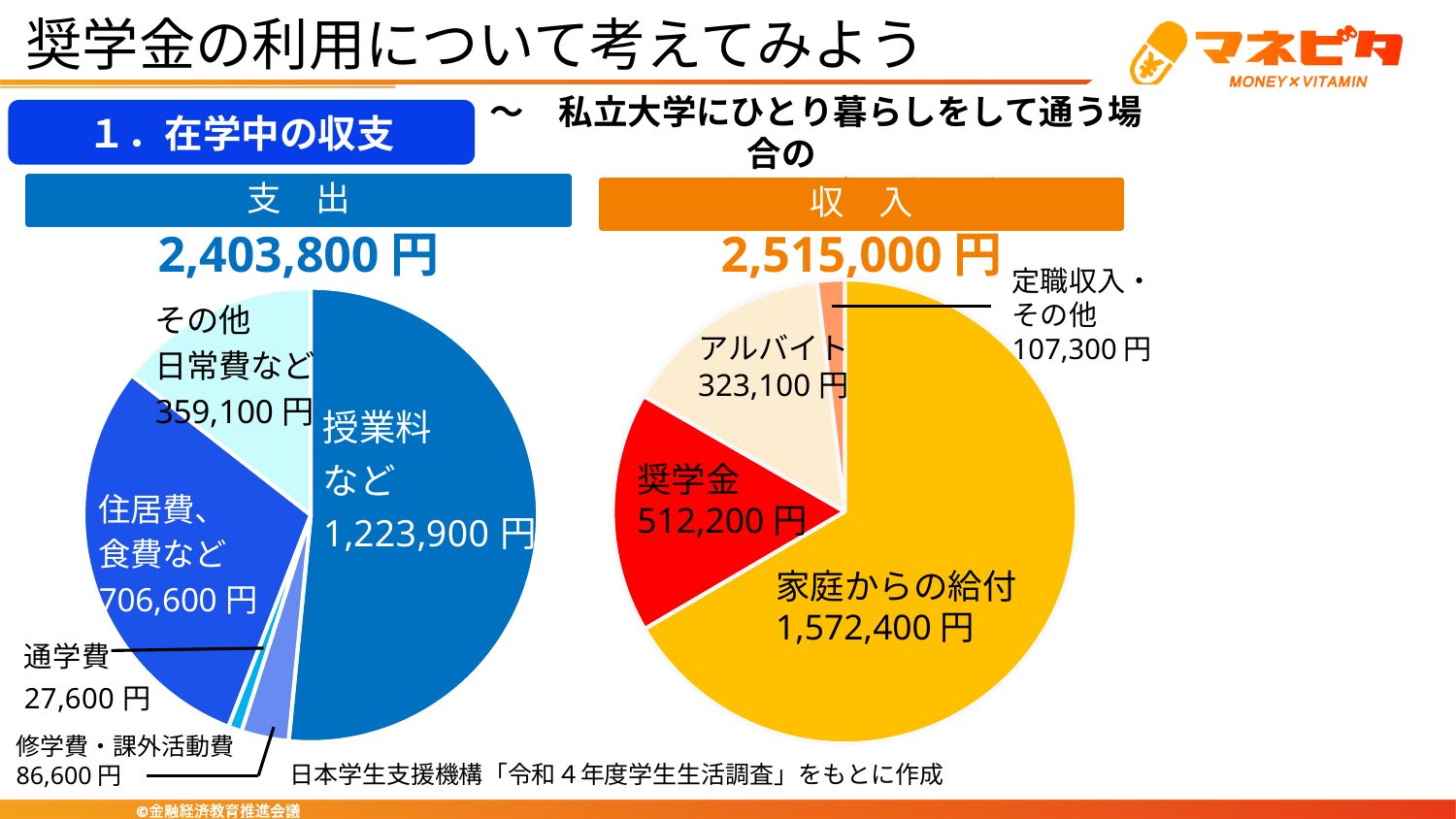
What type of chart is used for 支出 on the left? Pie chart In the 支出 pie chart on the left, what is the value for 授業料など? 1,223,900 円 How many categories does the 収入 pie chart on the right show? 4 In the 収入 pie chart on the right, which category has the smallest value? 定職収入・その他 What is the total amount shown above the 収入 pie chart on the right? 2,515,000 円 How many categories does the 支出 pie chart on the left show? 5 In the 収入 pie chart on the right, what is the value for 奨学金? 512,200 円 In the 支出 pie chart on the left, which category has the largest value? 授業料など In the 支出 pie chart on the left, which is larger: 住居費、食費など or その他日常費など? 住居費、食費など In the 支出 pie chart on the left, which category has the smallest value? 通学費 In the 収入 pie chart on the right, what is the value for アルバイト? 323,100 円 In the 収入 pie chart on the right, what is the difference between 家庭からの給付 and 奨学金? 1,060,200 円